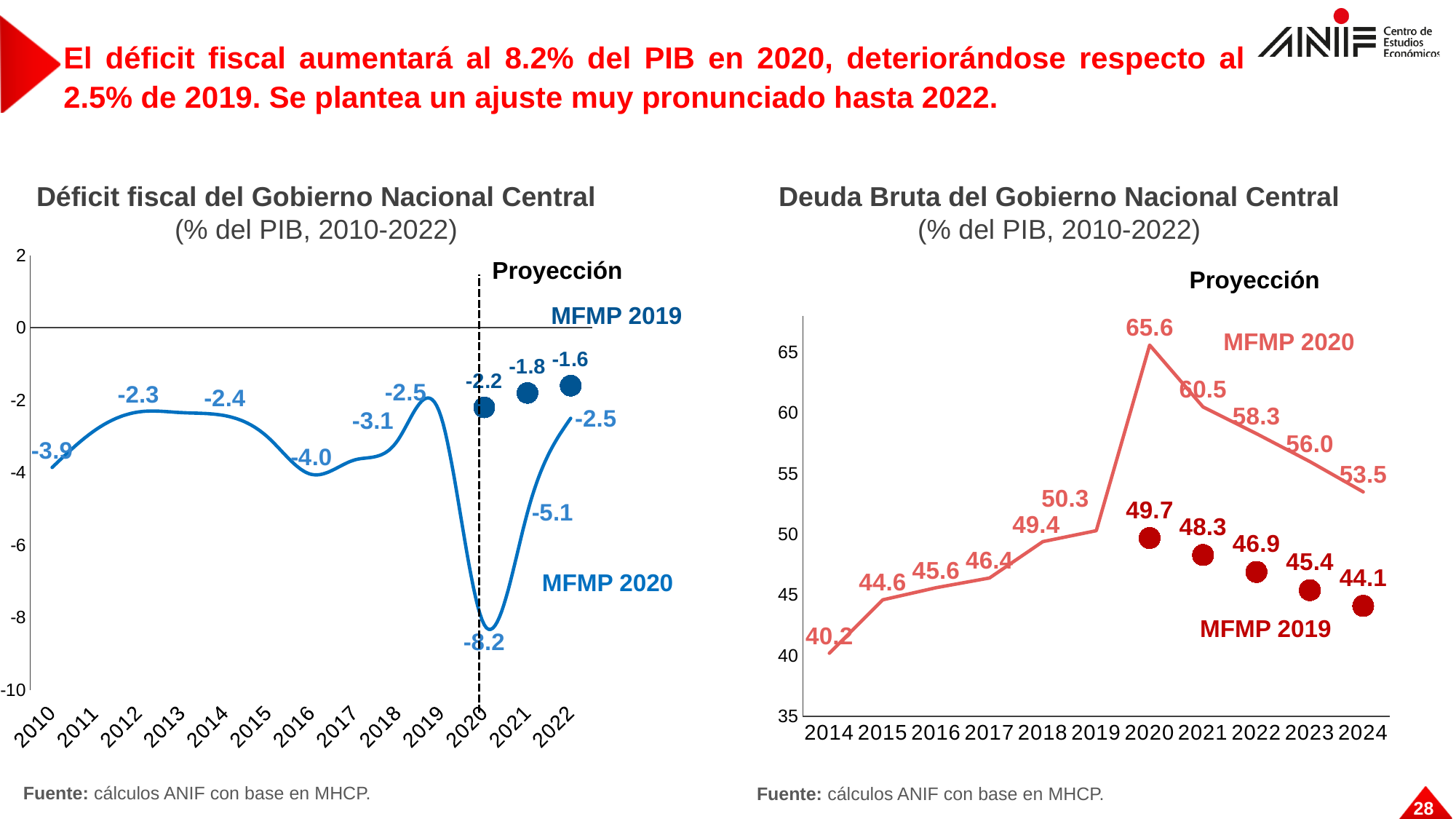
What kind of chart is the 'Déficit fiscal del Gobierno Nacional Central' chart? line chart In the 'Deuda Bruta del Gobierno Nacional Central' chart, how many years are shown on the x axis? 11 In the 'Deuda Bruta del Gobierno Nacional Central' chart, which year has the lowest MFMP 2020 value? 2014 In the 'Deuda Bruta del Gobierno Nacional Central' chart, is the MFMP 2020 value for 2021 greater or less than 60? greater In the 'Deuda Bruta del Gobierno Nacional Central' chart, what is the difference between the MFMP 2020 and MFMP 2019 values for 2022? 11.4 In the 'Deuda Bruta del Gobierno Nacional Central' chart, what is the MFMP 2020 value for 2020? 65.6 In the 'Déficit fiscal del Gobierno Nacional Central' chart, what is the MFMP 2019 value for 2021? -1.8 In the 'Deuda Bruta del Gobierno Nacional Central' chart, do the MFMP 2019 values rise or fall from 2020 to 2024? fall In the 'Deuda Bruta del Gobierno Nacional Central' chart, what is the MFMP 2019 value for 2024? 44.1 In the 'Deuda Bruta del Gobierno Nacional Central' chart, which year has the highest MFMP 2020 value? 2020 In the 'Déficit fiscal del Gobierno Nacional Central' chart, what is the difference between the MFMP 2020 and MFMP 2019 values for 2022? 0.9 In the 'Déficit fiscal del Gobierno Nacional Central' chart, what is the MFMP 2020 value for 2020? -8.2